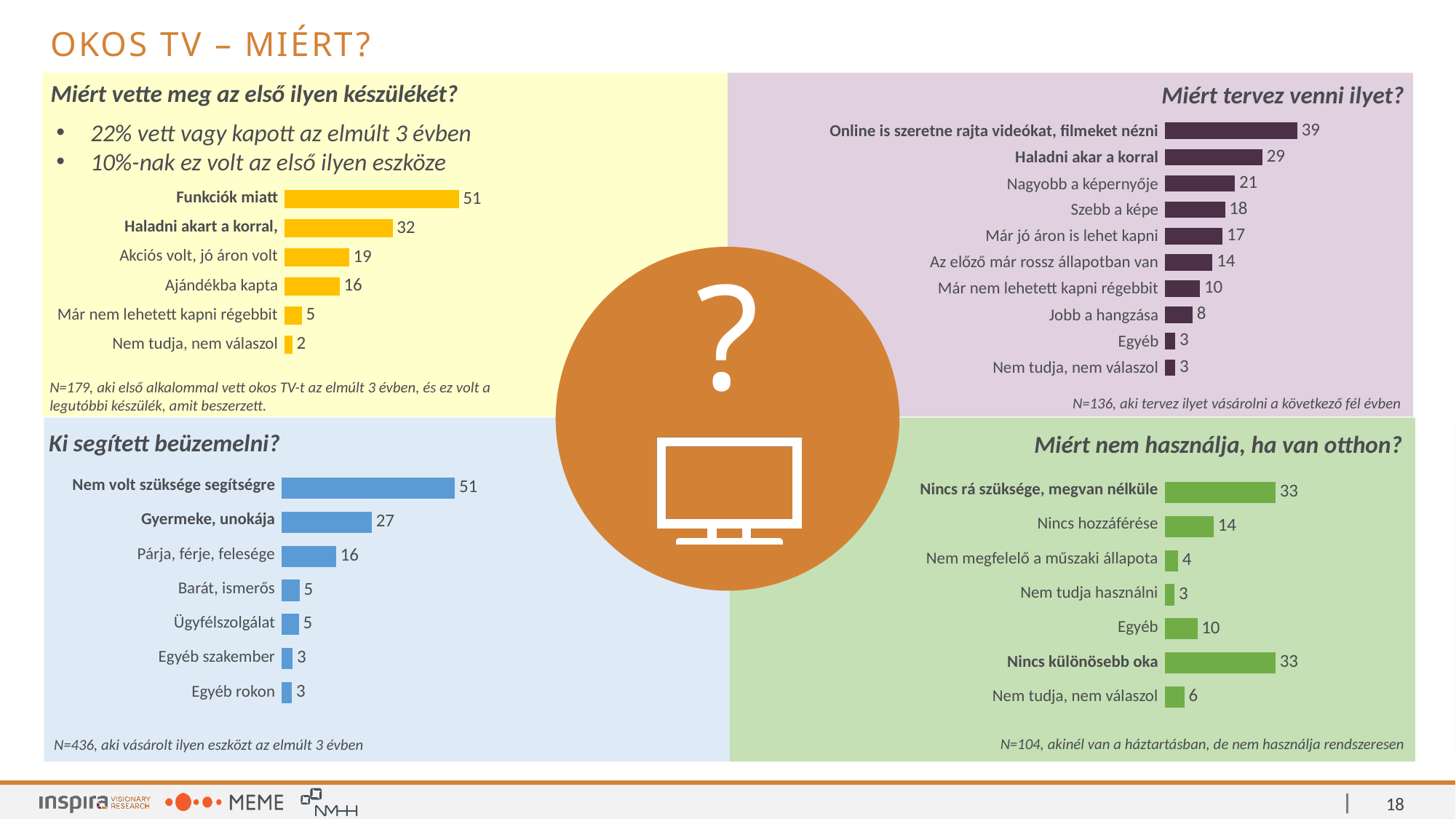
In the chart 'Ki segített beüzemelni?', which is larger: 'Párja, férje, felesége' or 'Barát, ismerős'? Párja, férje, felesége What type of chart is 'Miért nem használja, ha van otthon?'? Bar chart How many categories are shown in the chart 'Ki segített beüzemelni?'? 7 In the chart 'Miért tervez venni ilyet?', which category has the highest value? Online is szeretne rajta videókat, filmeket nézni How many categories are shown in the chart 'Miért tervez venni ilyet?'? 10 In the chart 'Miért vette meg az első ilyen készülékét?', what is the value for 'Funkciók miatt'? 51 In the chart 'Miért nem használja, ha van otthon?', which category has the lowest value? Nem tudja használni In the chart 'Miért tervez venni ilyet?', what is the value for 'Nagyobb a képernyője'? 21 In the chart 'Miért vette meg az első ilyen készülékét?', what is the difference between 'Funkciók miatt' and 'Haladni akart a korral,'? 19 In the chart 'Miért vette meg az első ilyen készülékét?', which category has the lowest value? Nem tudja, nem válaszol In the chart 'Ki segített beüzemelni?', what is the value for 'Gyermeke, unokája'? 27 In the chart 'Miért nem használja, ha van otthon?', what is the value for 'Nincs hozzáférése'? 14